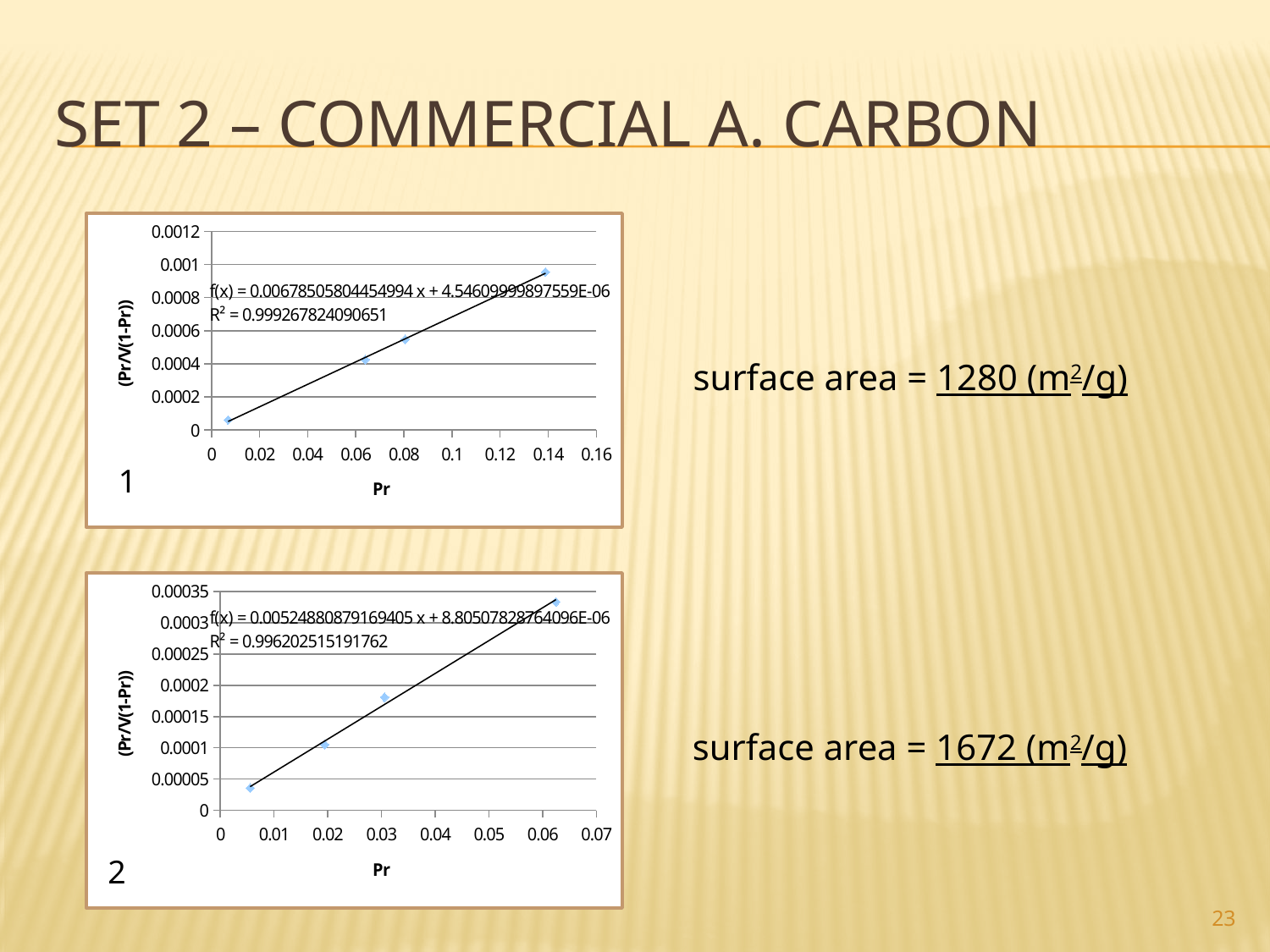
What is the x-axis title of the bottom chart (chart 2)? Pr In the top chart (chart 1), is the value for the point at the highest Pr greater or less than 0.0008? greater What is the R² value shown on the top chart (chart 1)? 0.999267824090651 What kind of chart is the top chart (chart 1)? scatter chart How many data points are plotted in the bottom chart (chart 2)? 4 In the top chart (chart 1), do the values rise or fall as Pr increases? rise In the bottom chart (chart 2), do the values rise or fall as Pr increases? rise How many data points are plotted in the top chart (chart 1)? 4 In the bottom chart (chart 2), is the value for the point at the lowest Pr greater or less than 0.0001? less In the bottom chart (chart 2), is the value for the point at the highest Pr greater or less than 0.0003? greater